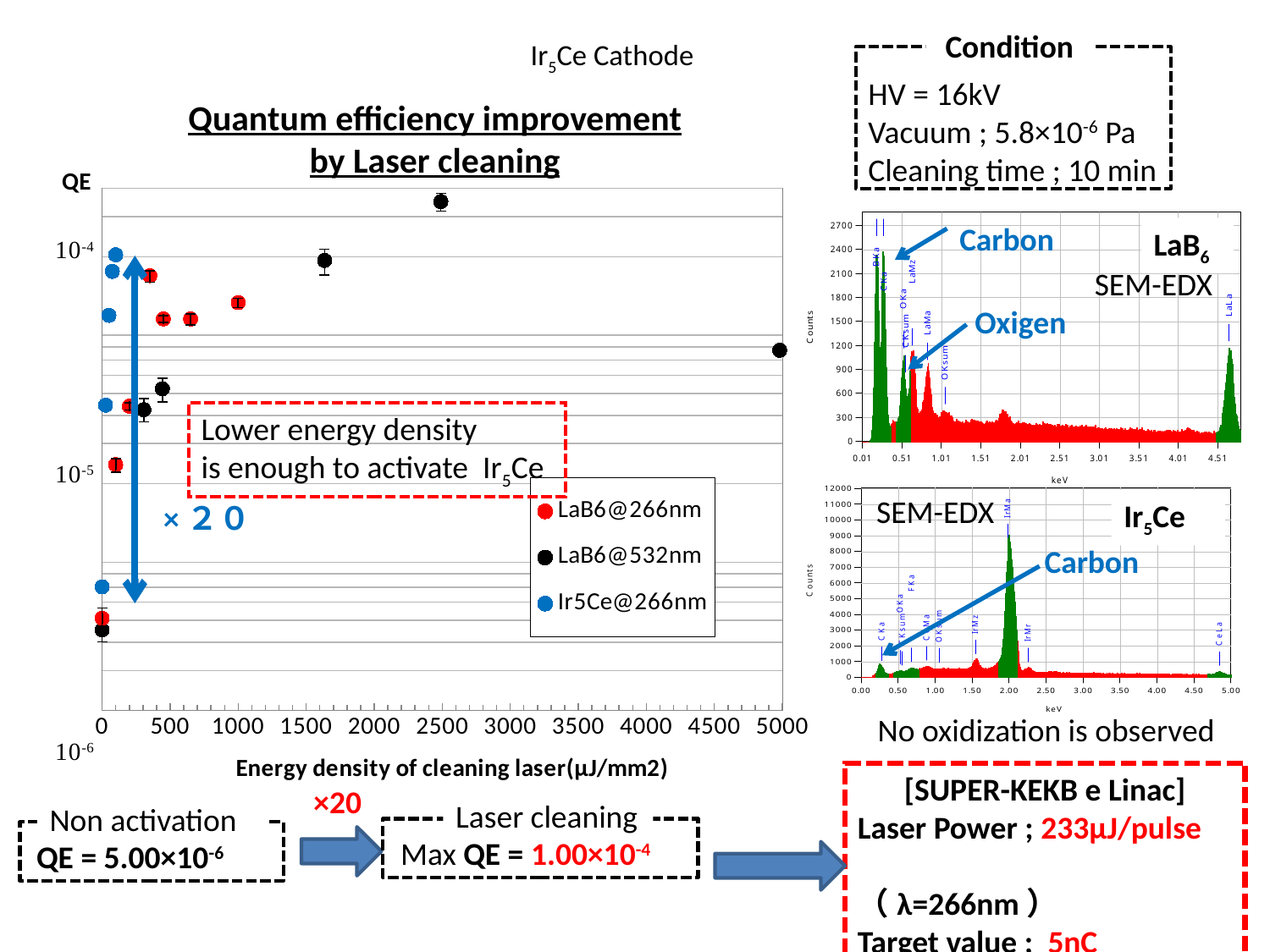
In the 'Quantum efficiency improvement by Laser cleaning' chart, does the LaB6@532nm QE rise or fall between energy densities of about 300 and 2500? rise What kind of chart is the 'Quantum efficiency improvement by Laser cleaning' chart? Scatter chart How many series does the legend of the 'Quantum efficiency improvement by Laser cleaning' chart list? 3 In the 'Quantum efficiency improvement by Laser cleaning' chart, which series is plotted with blue markers? Ir5Ce@266nm In the 'Quantum efficiency improvement by Laser cleaning' chart, which series contains the highest plotted QE value? LaB6@532nm In the LaB6 SEM-EDX chart, what is the highest value shown on the Counts axis? 2700 What is the x-axis label of the 'Quantum efficiency improvement by Laser cleaning' chart? Energy density of cleaning laser(μJ/mm2) In the Ir5Ce SEM-EDX chart, is the IrMa peak near 2.00 keV greater or less than 8000 counts? greater In the 'Quantum efficiency improvement by Laser cleaning' chart, which series has a data point at the largest energy density (5000)? LaB6@532nm In the 'Quantum efficiency improvement by Laser cleaning' chart, is the LaB6@532nm value at an energy density of about 2500 greater or less than 10^-4? greater In the 'Quantum efficiency improvement by Laser cleaning' chart, is the LaB6@532nm value at an energy density of 5000 greater or less than 10^-4? less